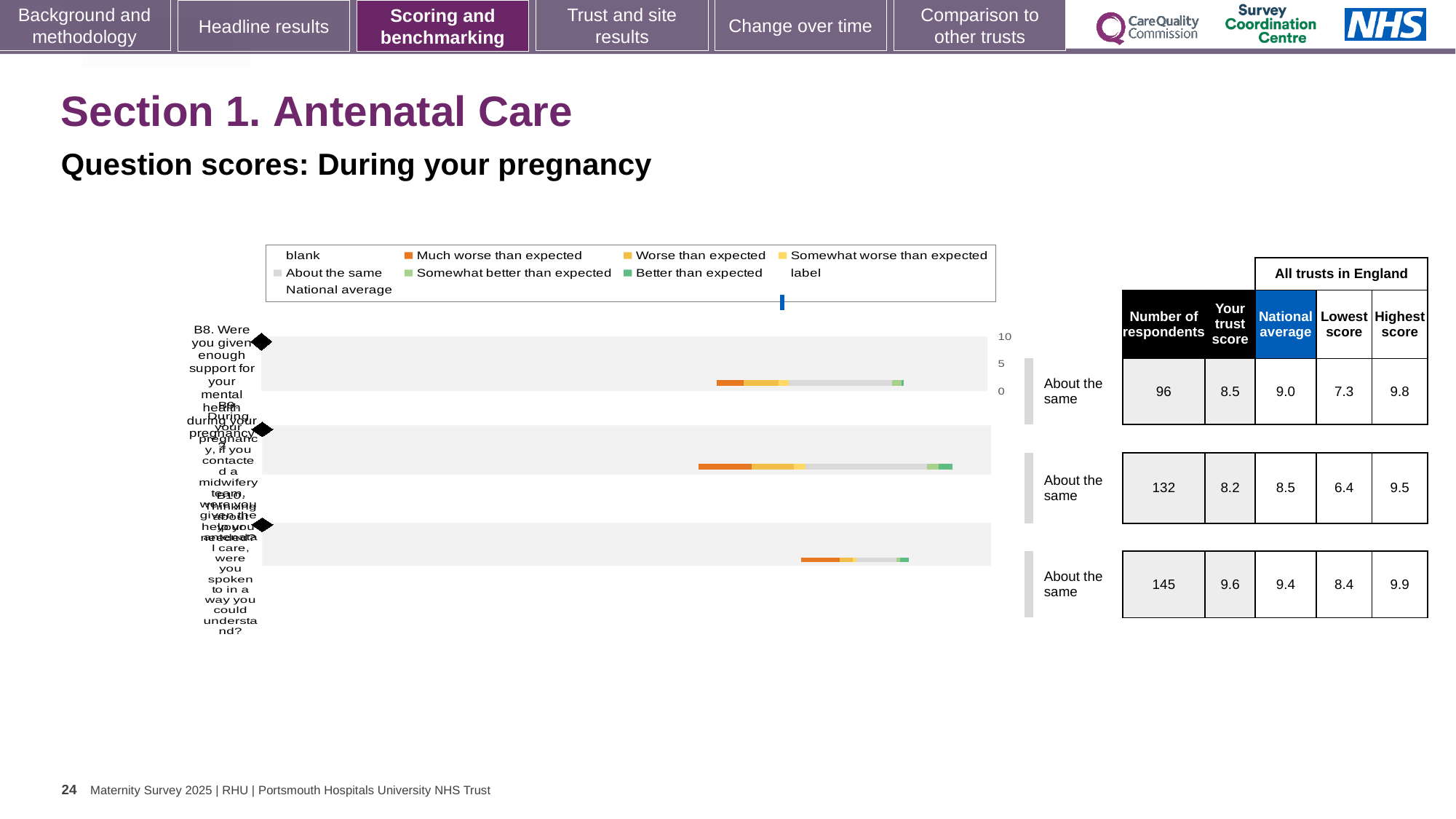
In the bottom row of the table, what is the difference between 'Your trust score' and the national average? 0.2 What colour does the legend use for 'Much worse than expected'? orange What is the highest value shown on the chart's axis? 10 What benchmark label is shown next to each of the three bars? About the same In the table, what is the national average for the middle row? 8.5 In the top row of the table, which is larger: 'Your trust score' or the national average? National average What kind of chart is shown on the slide? bar chart In the table, what is the lowest score for the middle row? 6.4 Which row of the table has the highest number of respondents? the bottom row (145) In the table, what is the number of respondents for the top row? 96 In the table, what is 'Your trust score' for the bottom row? 9.6 How many question bars are plotted in the chart? 3